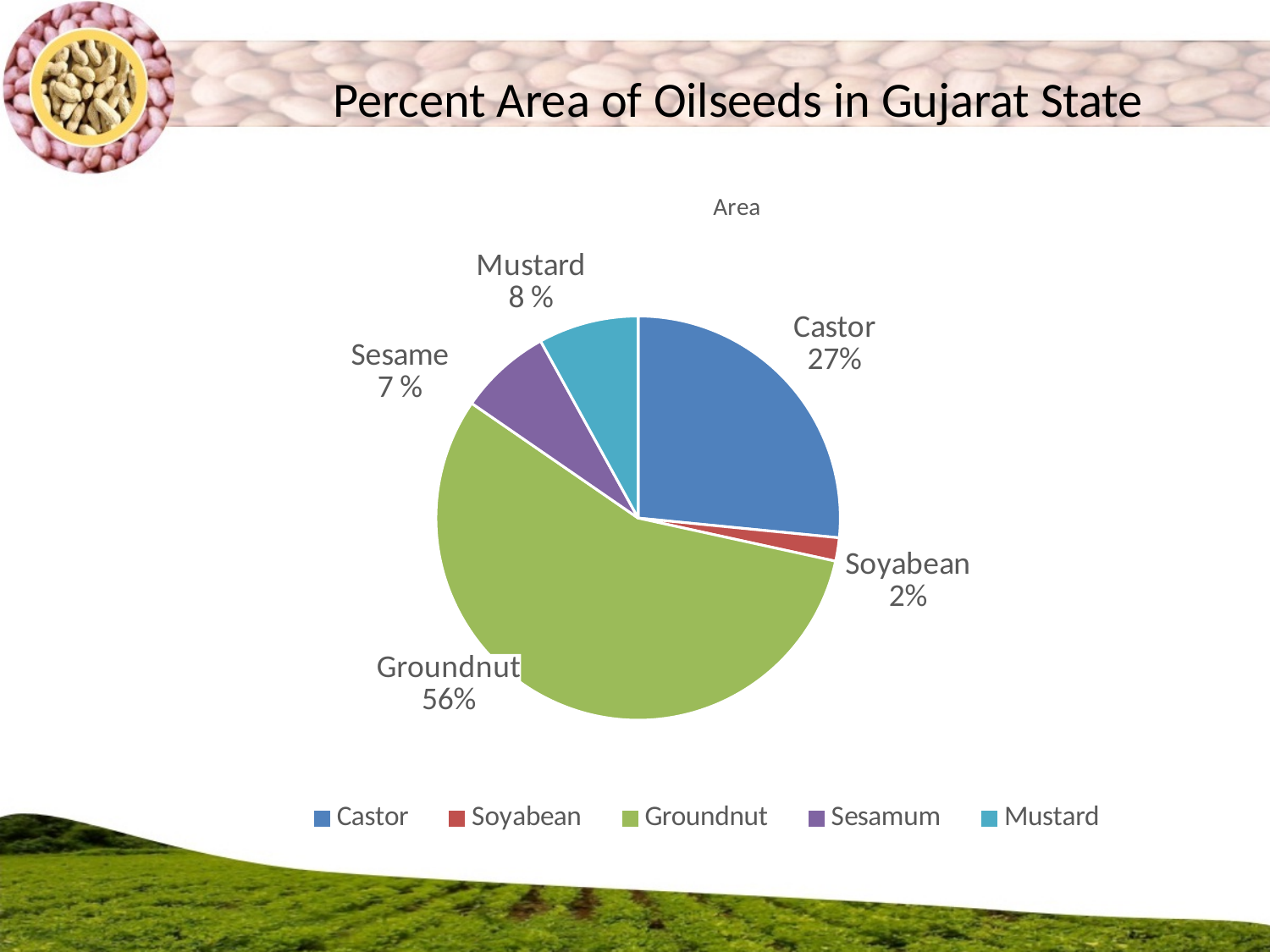
What is the percent area for Soyabean? 2% What is the percent area for Mustard? 8 % What colour is the Groundnut slice? green What is the difference between the Groundnut and Castor percentages? 29% Which has a larger share of area, Mustard or Sesame? Mustard Which oilseed has the smallest share of area? Soyabean What is the percent area for Groundnut? 56% How many slices does the pie chart have? 5 Which oilseed has the largest share of area? Groundnut What kind of chart is shown on the slide? pie chart What is the percent area for Castor? 27% What is the title shown above the pie chart? Area